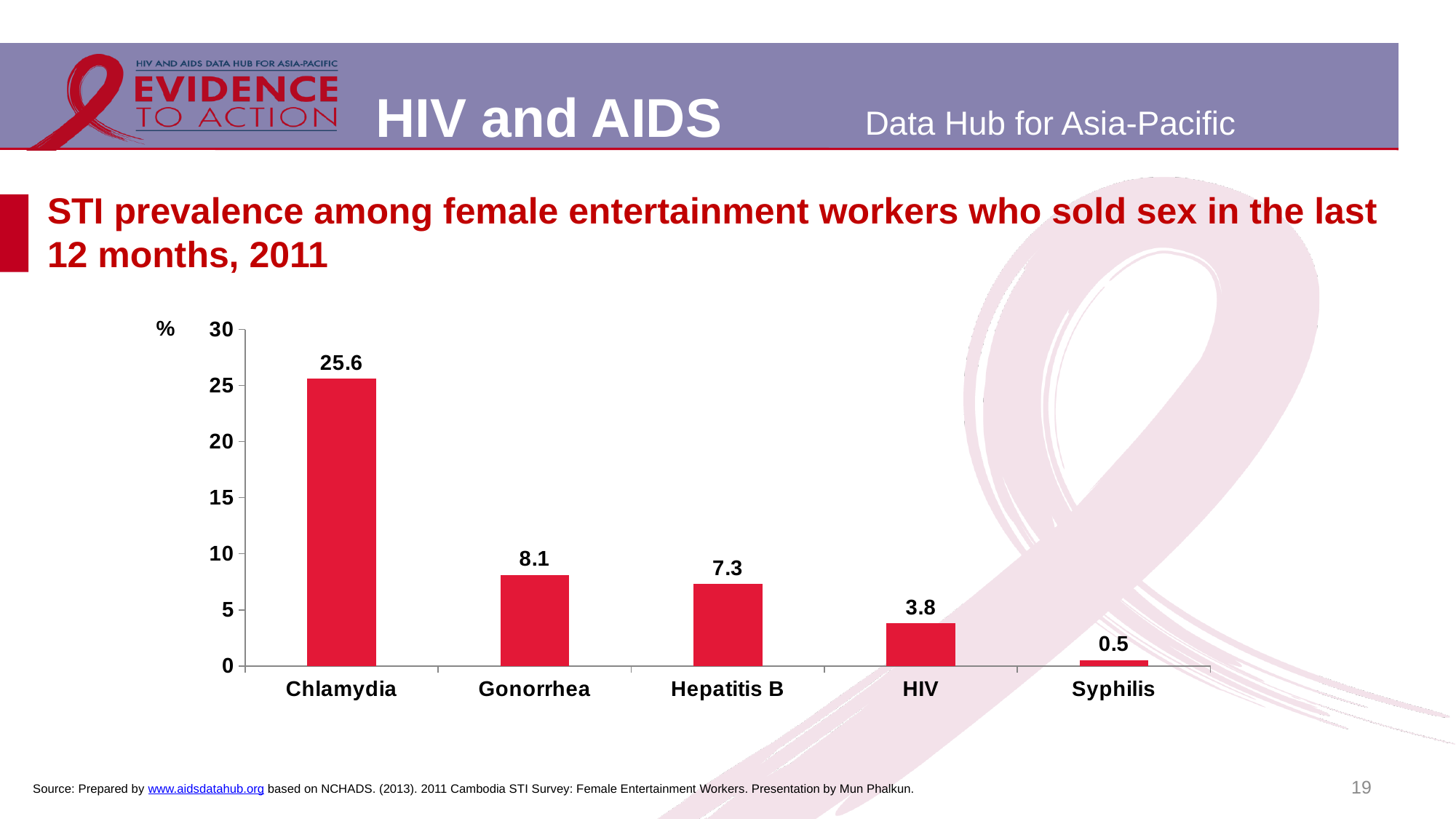
What is the difference between the values for Chlamydia and Gonorrhea? 17.5 What is the value shown for Syphilis? 0.5 How many STI categories are shown on the x axis? 5 What is the STI prevalence value shown for Chlamydia? 25.6 What is the value shown for HIV? 3.8 What is the value shown for Gonorrhea? 8.1 What is the value shown for Hepatitis B? 7.3 What unit is indicated on the y axis of the chart? % Which STI has the highest prevalence in the chart? Chlamydia Which is larger, the value for Gonorrhea or the value for Hepatitis B? Gonorrhea Which STI has the lowest prevalence in the chart? Syphilis What kind of chart is shown on the slide? Bar chart